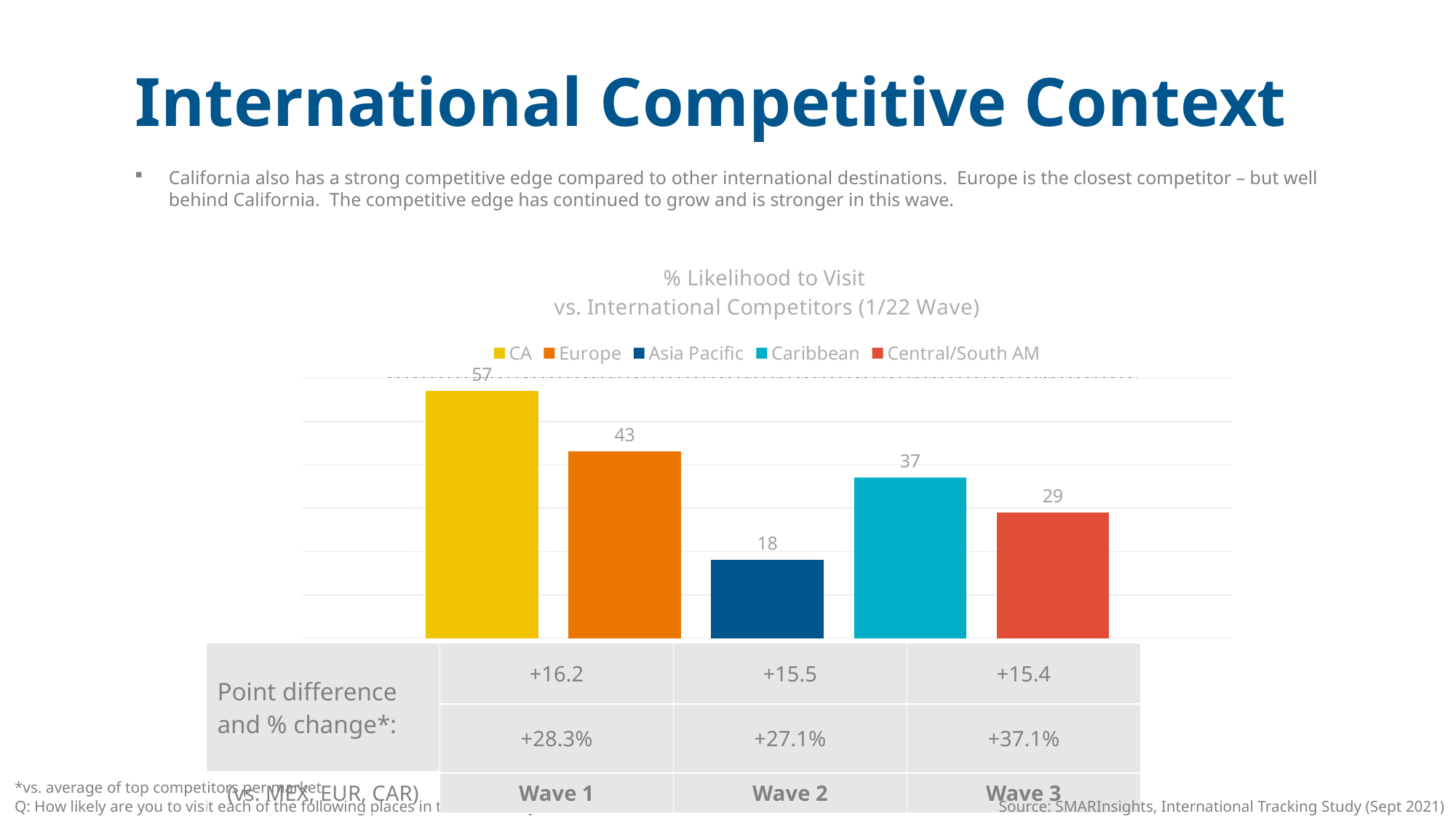
What is the value for CA in the chart? 57 How many series does the legend list? 5 What kind of chart is shown on the slide? Bar chart What is the value for Europe in the chart? 43 What is the value for Central/South AM in the chart? 29 Which destination has the lowest % likelihood to visit? Asia Pacific What is the title of the chart? % Likelihood to Visit vs. International Competitors (1/22 Wave) What is the difference between the values for CA and Europe? 14 Which is larger, the value for Caribbean or the value for Central/South AM? Caribbean What is the value for Caribbean in the chart? 37 Which destination has the highest % likelihood to visit? CA What is the value for Asia Pacific in the chart? 18